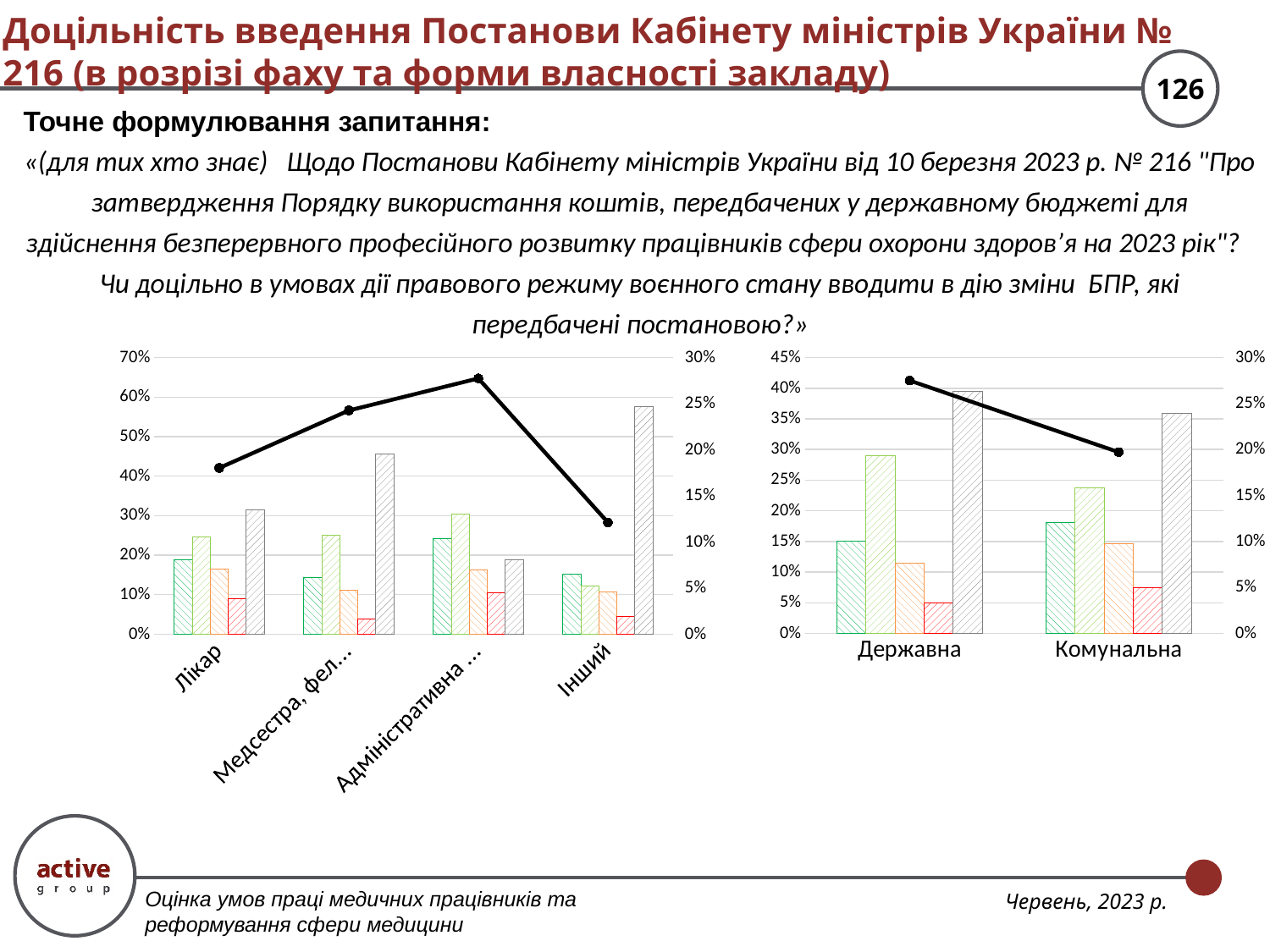
In the right chart, does the black line rise or fall from Державна to Комунальна? fall In the left chart, is the black line value for Адміністративна (right axis) greater or less than 25%? greater How many bars are plotted for each category in the right chart? 5 How many categories are shown on the x axis of the left chart? 4 What kind of chart is the left chart? bar chart with a line In the left chart, which category has the highest point on the black line? Адміністративна In the left chart, is the black line value for Інший (right axis) greater or less than 15%? less In the left chart, which category has the lowest point on the black line? Інший How many categories are shown on the x axis of the right chart? 2 In the right chart, which category has the taller grey hatched bar, Державна or Комунальна? Державна In the right chart, is the grey hatched bar for Державна greater or less than 35%? greater